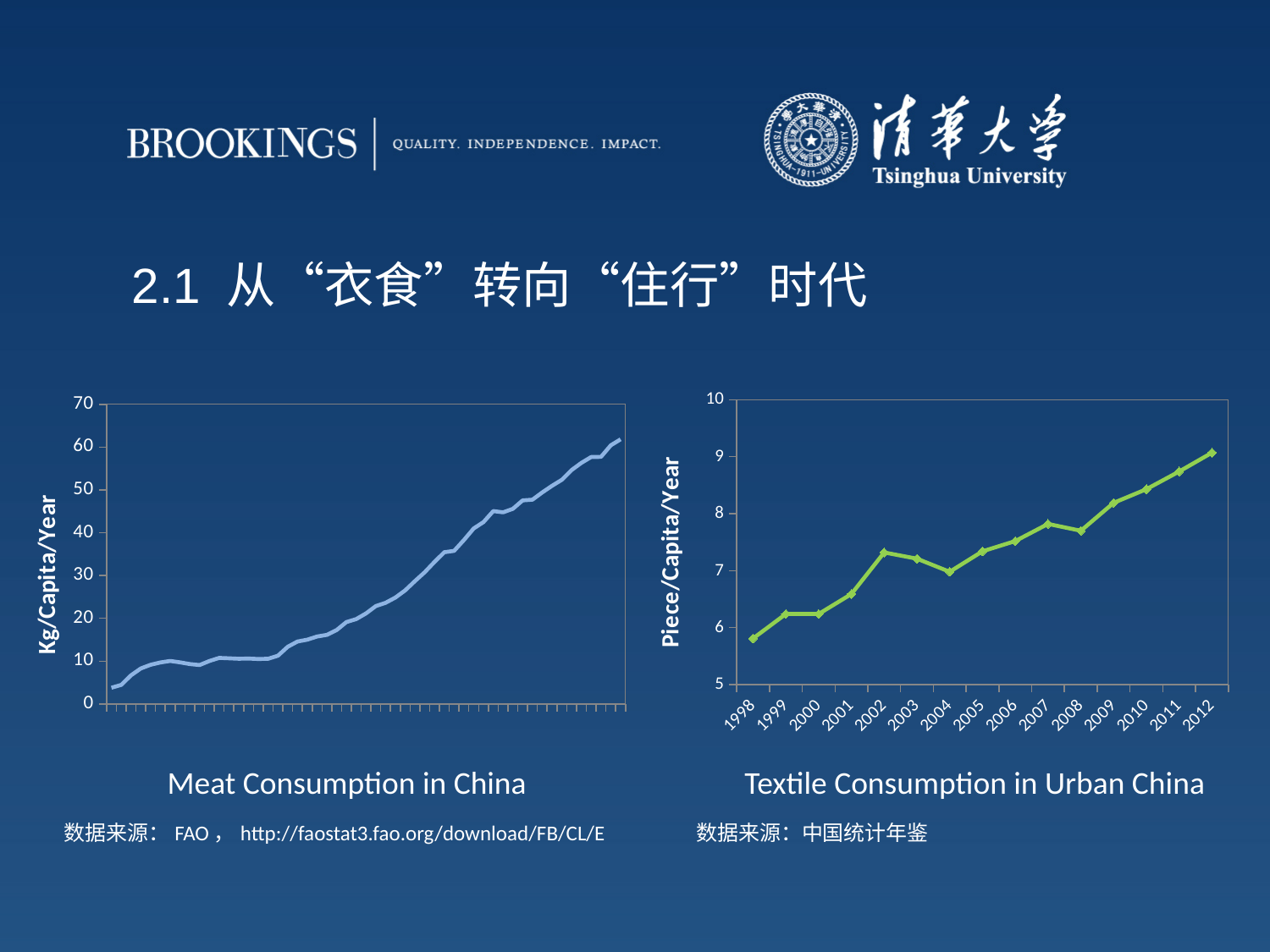
What is the y-axis label of the "Textile Consumption in Urban China" chart? Piece/Capita/Year What kind of chart is the "Textile Consumption in Urban China" chart? line chart In the "Textile Consumption in Urban China" chart, do the values generally rise or fall from 1998 to 2012? rise In the "Meat Consumption in China" chart, do the values generally rise or fall along the x axis? rise What kind of chart is the "Meat Consumption in China" chart? line chart What is the y-axis label of the "Meat Consumption in China" chart? Kg/Capita/Year In the "Textile Consumption in Urban China" chart, which year has the larger value, 2002 or 2004? 2002 In the "Textile Consumption in Urban China" chart, which year has the highest value? 2012 In the "Textile Consumption in Urban China" chart, how many years are plotted on the x axis? 15 In the "Textile Consumption in Urban China" chart, is the value for 1998 greater or less than 6? less In the "Textile Consumption in Urban China" chart, which year has the lowest value? 1998